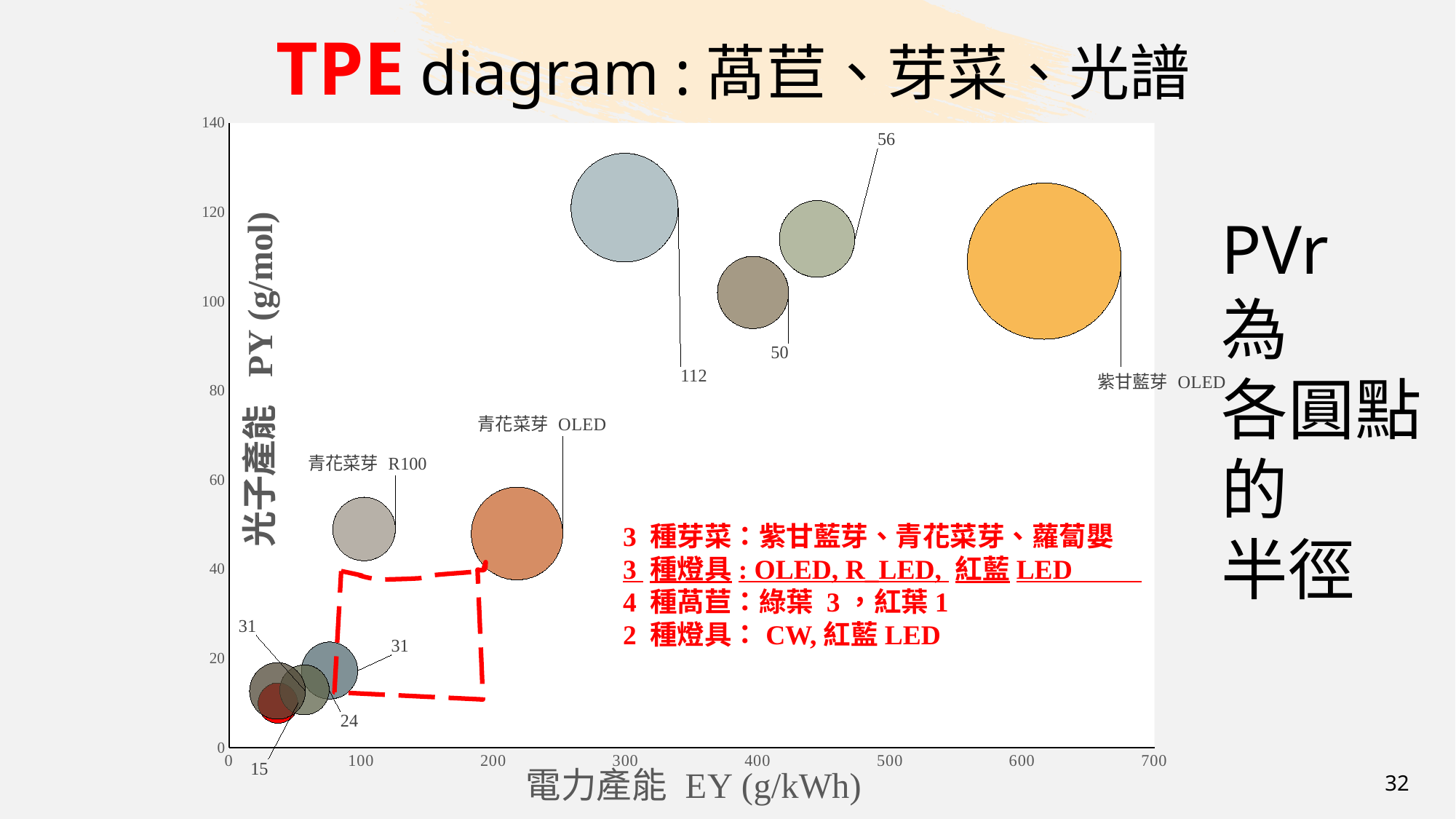
Which named bubble is positioned furthest to the right on the EY axis? 紫甘藍芽 OLED Which bubble has the higher PY value, 紫甘藍芽 OLED or 青花菜芽 R100? 紫甘藍芽 OLED Is the EY value for the 紫甘藍芽 OLED bubble greater or less than 500? greater Which bubble has the higher EY value, 紫甘藍芽 OLED or 青花菜芽 OLED? 紫甘藍芽 OLED What kind of chart is shown on the slide? bubble chart What is the title of the x axis? 電力產能 EY (g/kWh) What number labels the brown bubble located near EY 400? 50 What number labels the gray-green bubble located near EY 450? 56 Is the PY value for the 青花菜芽 R100 bubble greater or less than 60? less Is the EY value for the 青花菜芽 OLED bubble greater or less than 100? greater What number labels the large blue-gray bubble located near EY 300? 112 What is the title of the y axis? 光子產能 PY (g/mol)